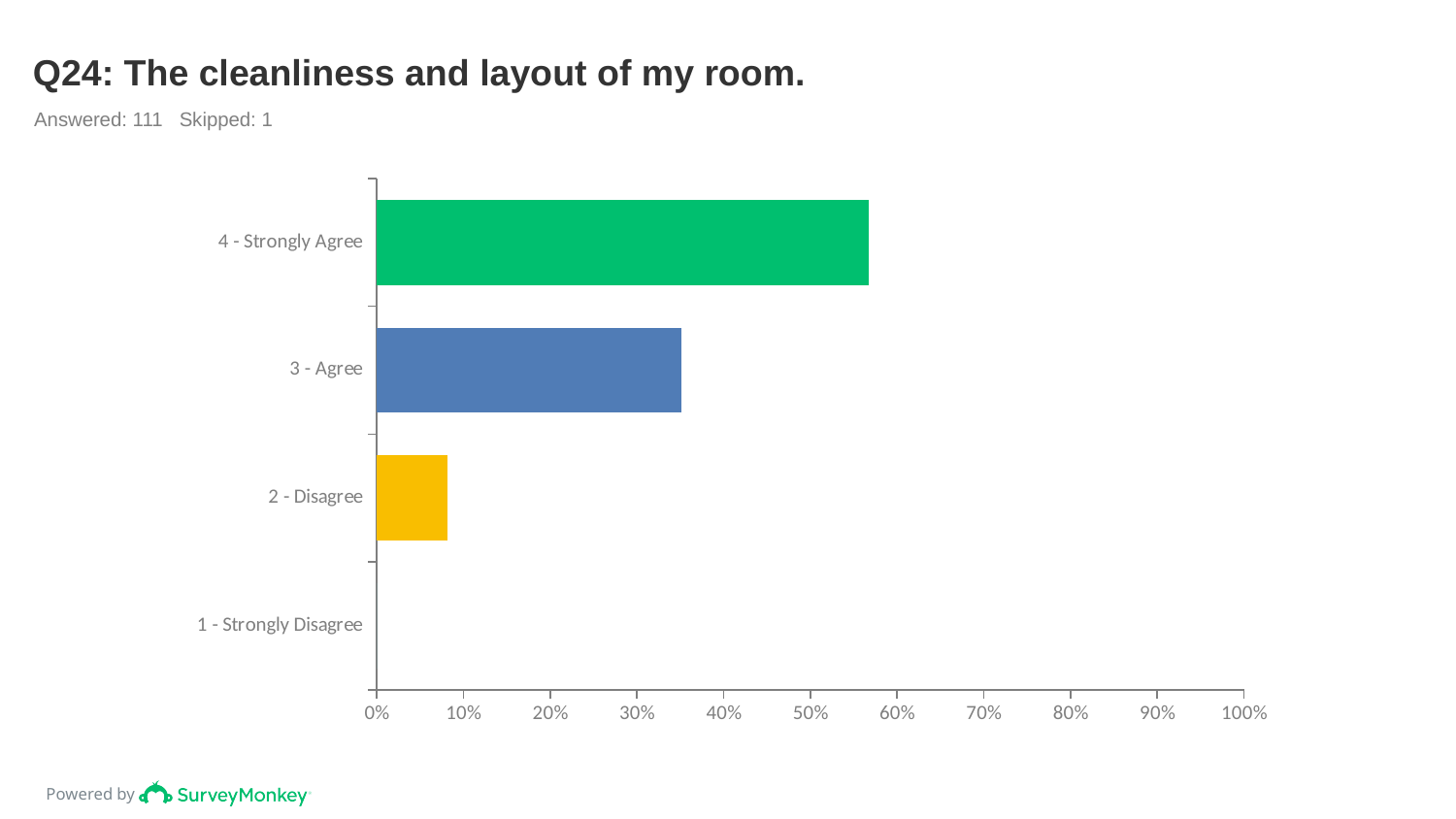
Is the value for 3 - Agree greater or less than 30%? greater What is the title of the chart? Q24: The cleanliness and layout of my room. Which is larger, the value for 4 - Strongly Agree or the value for 3 - Agree? 4 - Strongly Agree What kind of chart is shown on the slide? bar chart Which response category has the highest value? 4 - Strongly Agree Is the value for 3 - Agree greater or less than 40%? less Which response category has the lowest value? 1 - Strongly Disagree What colour is the bar for 4 - Strongly Agree? green How many response categories are shown on the chart? 4 Is the value for 4 - Strongly Agree greater or less than 50%? greater Which is larger, the value for 3 - Agree or the value for 2 - Disagree? 3 - Agree